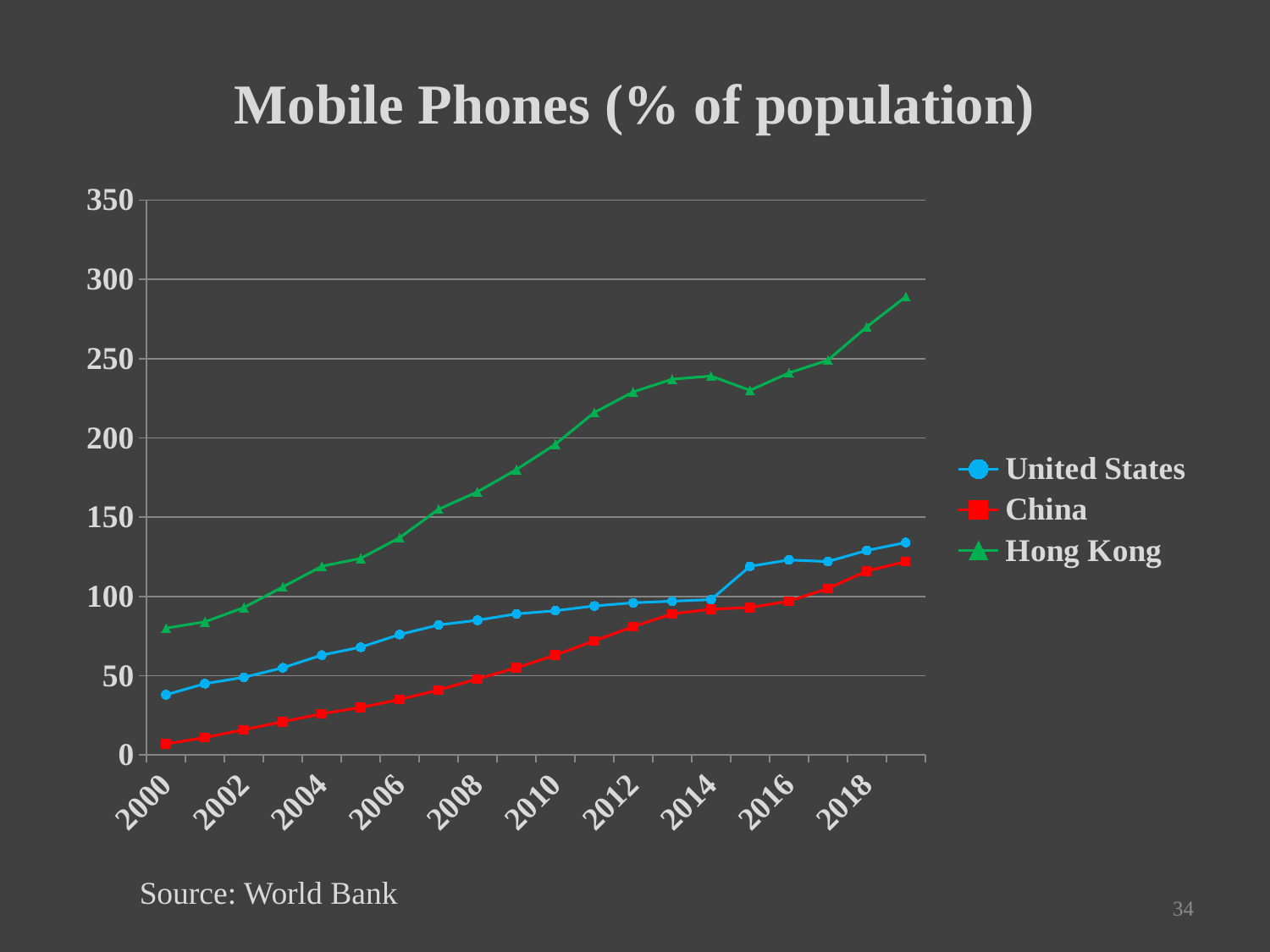
What is the title of the chart? Mobile Phones (% of population) What kind of chart is shown on the slide? line chart In 2004, which is larger: the value for the United States or the value for China? United States Is the value for Hong Kong in 2012 greater or less than 200? greater Which series is represented by the green line with triangle markers? Hong Kong Is the value for Hong Kong in 2018 greater or less than 250? greater Is the value for China in 2000 greater or less than 50? less Which series has the highest value in 2018? Hong Kong How many series does the legend list? 3 Does the China series generally rise or fall from 2000 to 2018? rise Which series has the lowest value in 2000? China